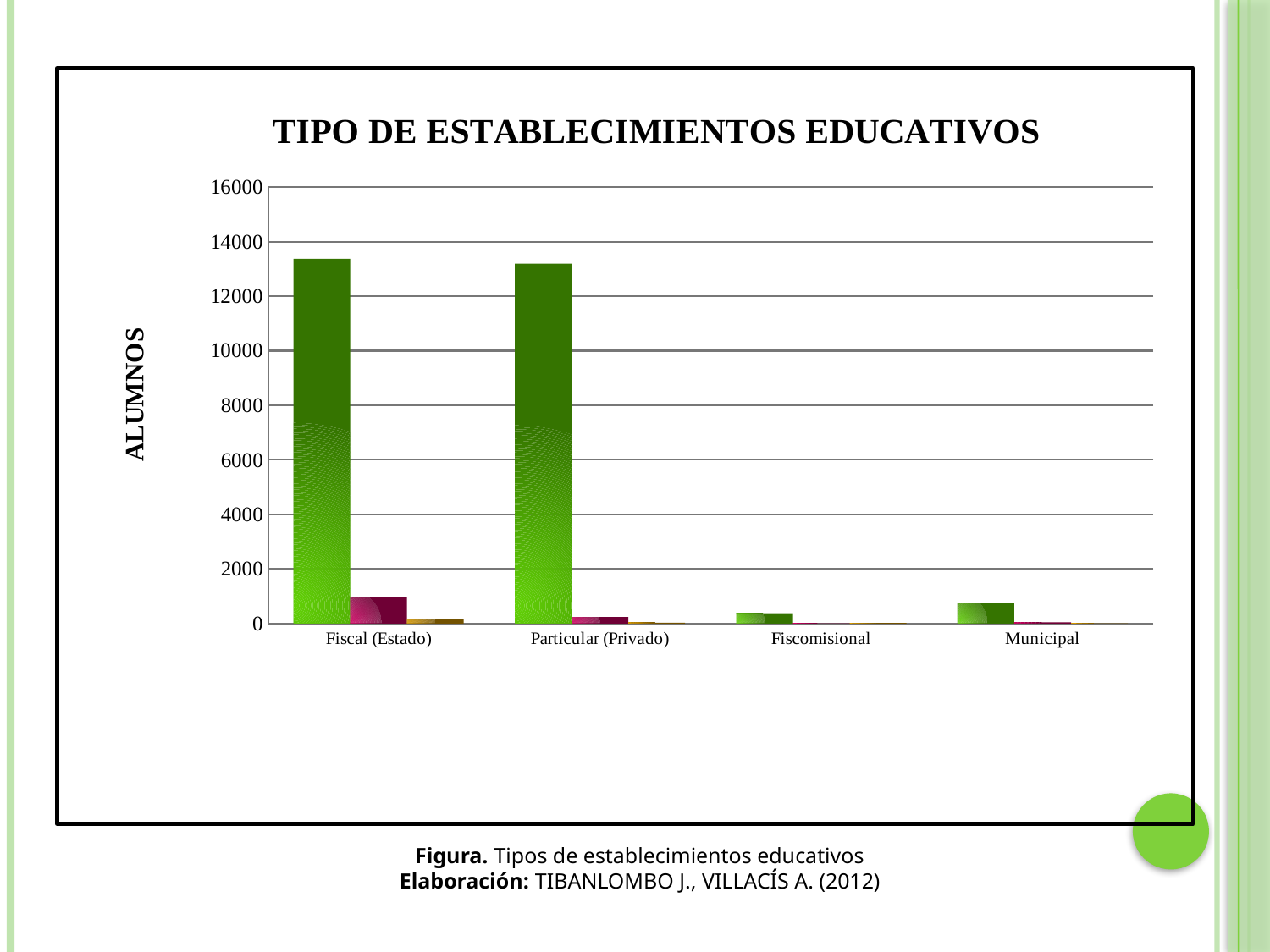
Is the value of the green bar for Municipal greater or less than 2000? less Is the value of the magenta bar for Fiscal (Estado) greater or less than 2000? less Which category has the lowest green bar? Fiscomisional What kind of chart is shown on the slide? bar chart Is the value of the tallest (green) bar for Fiscal (Estado) greater or less than 12000? greater What is the label on the vertical axis of the chart? ALUMNOS How many categories are shown on the x axis of the chart? 4 What is the title of the chart? TIPO DE ESTABLECIMIENTOS EDUCATIVOS Which has the larger green bar, Fiscomisional or Municipal? Municipal Which has the larger magenta bar, Fiscal (Estado) or Particular (Privado)? Fiscal (Estado)